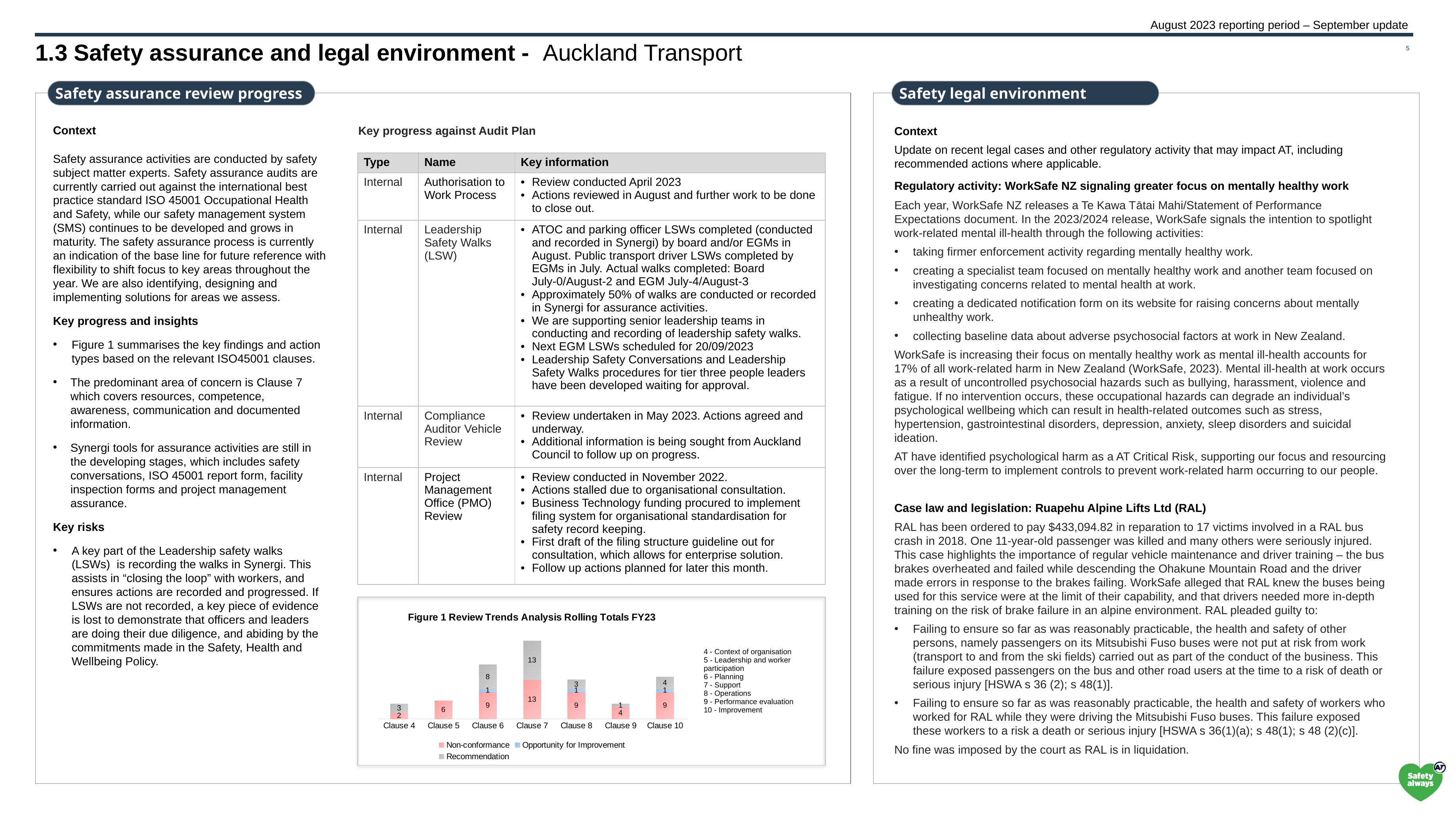
In Figure 1, what is the difference between the Recommendation values for Clause 7 and Clause 8? 10 How many clause categories are shown on the x axis of Figure 1? 7 In Figure 1, what is the total of the stacked bar for Clause 7? 26 How many series does the legend of Figure 1 list? 3 In Figure 1, which clause has the lowest Non-conformance value? Clause 4 In Figure 1, what is the Recommendation value for Clause 6? 8 In Figure 1, what is the total of the stacked bar for Clause 6? 18 In Figure 1, what is the Non-conformance value for Clause 7? 13 In Figure 1, which clause has the highest Non-conformance value? Clause 7 In Figure 1, which is larger: the Non-conformance value for Clause 6 or for Clause 9? Clause 6 In Figure 1, what is the Non-conformance value for Clause 5? 6 What kind of chart is Figure 1 Review Trends Analysis Rolling Totals FY23? Stacked bar chart